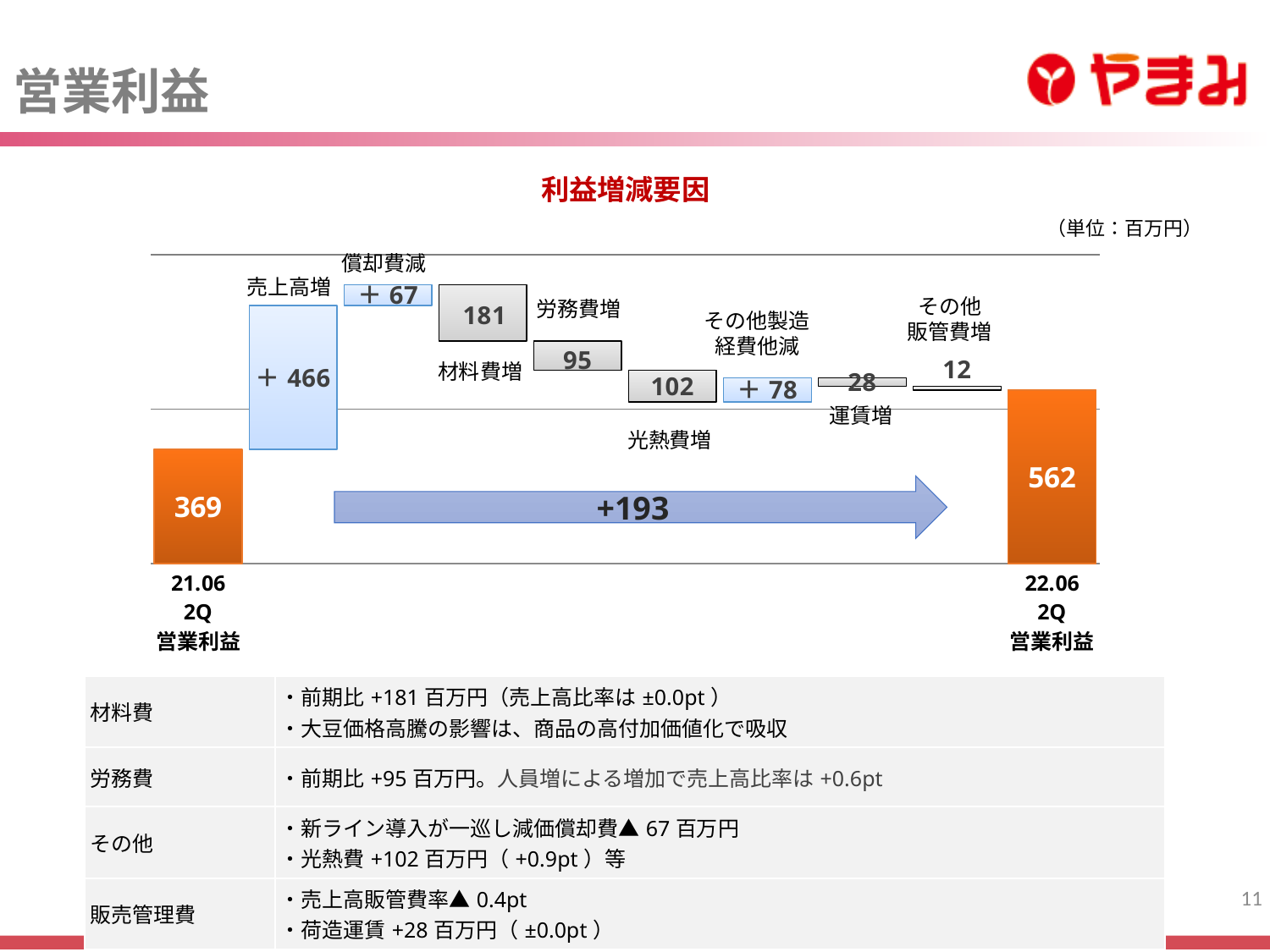
What is the difference between the 22.06 2Q operating profit and the 21.06 2Q operating profit? 193 What is the operating profit value shown for 22.06 2Q? 562 What is the total change in operating profit shown on the arrow between 21.06 2Q and 22.06 2Q? +193 What is the value shown for 償却費減 (depreciation decrease)? +67 What type of chart is shown on the slide? Waterfall chart What is the value shown for 労務費増 (labor cost increase)? 95 What is the value shown for 光熱費増 (utility cost increase)? 102 What is the value shown for 売上高増 (sales increase)? +466 What is the operating profit value shown for 21.06 2Q? 369 Which factor has the smallest value among the change factors in the chart? その他販管費増 What is the value shown for 材料費増 (material cost increase)? 181 Which factor has the largest value among the change factors in the chart? 売上高増